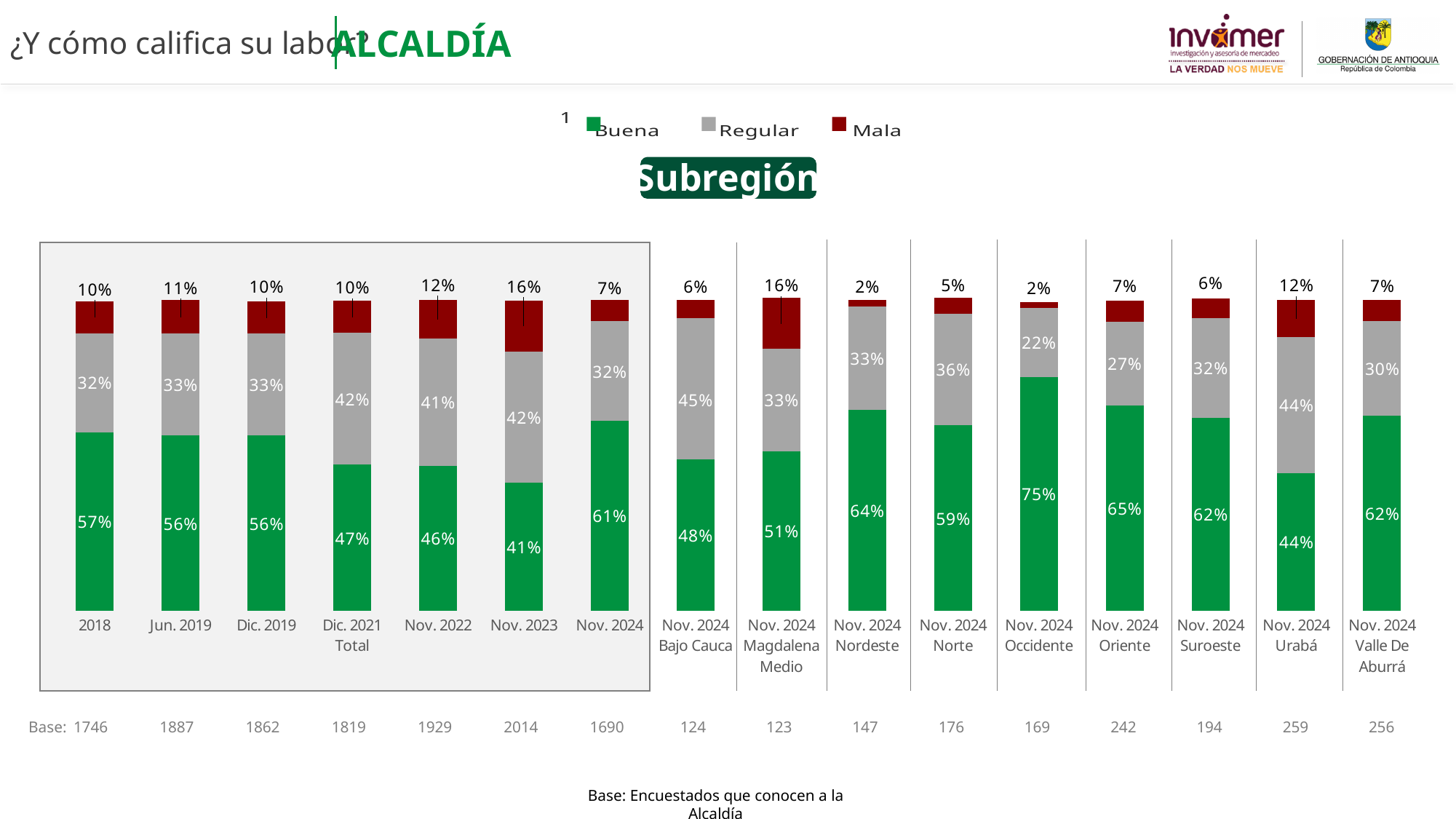
What is the 'Mala' value for Nov. 2023? 16% What is the total of the stacked bar for 2018 (Buena + Regular + Mala)? 99% What kind of chart is shown on the slide? Stacked bar chart How many series does the legend list? 3 What percentage of respondents rated the Alcaldía's work as 'Buena' in Nov. 2024 for Occidente? 75% Which colour represents 'Mala' in the legend? Dark red Which bar has the lowest 'Buena' percentage? Nov. 2023 Which has a higher 'Mala' value: Nov. 2024 Magdalena Medio or Nov. 2024 Urabá? Nov. 2024 Magdalena Medio What is the difference between the 'Buena' value for Nov. 2024 (Total) and Nov. 2023? 20 percentage points Which bar has the highest 'Buena' percentage? Nov. 2024 Occidente How many bars are shown in the chart? 16 What is the 'Regular' value for Nov. 2024 Bajo Cauca? 45%